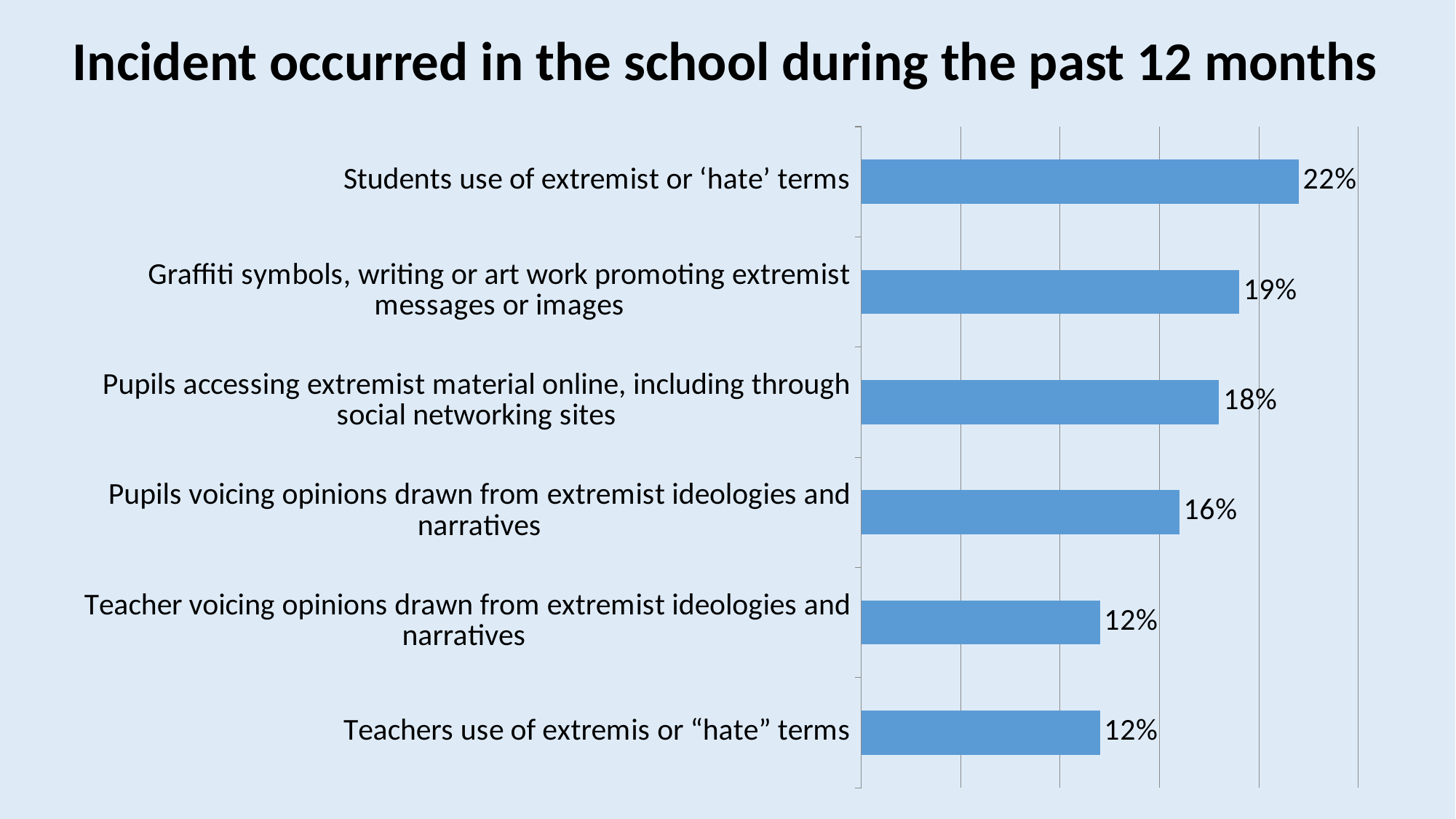
What percentage is shown for 'Students use of extremist or ‘hate’ terms'? 22% Which incident category has the highest value? Students use of extremist or ‘hate’ terms What is the difference between the value for 'Students use of extremist or ‘hate’ terms' and the value for 'Teachers use of extremis or “hate” terms'? 10% What percentage is shown for 'Pupils accessing extremist material online, including through social networking sites'? 18% What is the value for 'Graffiti symbols, writing or art work promoting extremist messages or images'? 19% What kind of chart is shown on the slide? Bar chart Which is larger: the value for 'Pupils accessing extremist material online, including through social networking sites' or the value for 'Teacher voicing opinions drawn from extremist ideologies and narratives'? Pupils accessing extremist material online, including through social networking sites What is the value for 'Pupils voicing opinions drawn from extremist ideologies and narratives'? 16% What is the difference between the values for 'Graffiti symbols, writing or art work promoting extremist messages or images' and 'Pupils voicing opinions drawn from extremist ideologies and narratives'? 3% How many incident categories are shown in the chart? 6 What is the title of the chart? Incident occurred in the school during the past 12 months What percentage is shown for 'Teacher voicing opinions drawn from extremist ideologies and narratives'? 12%